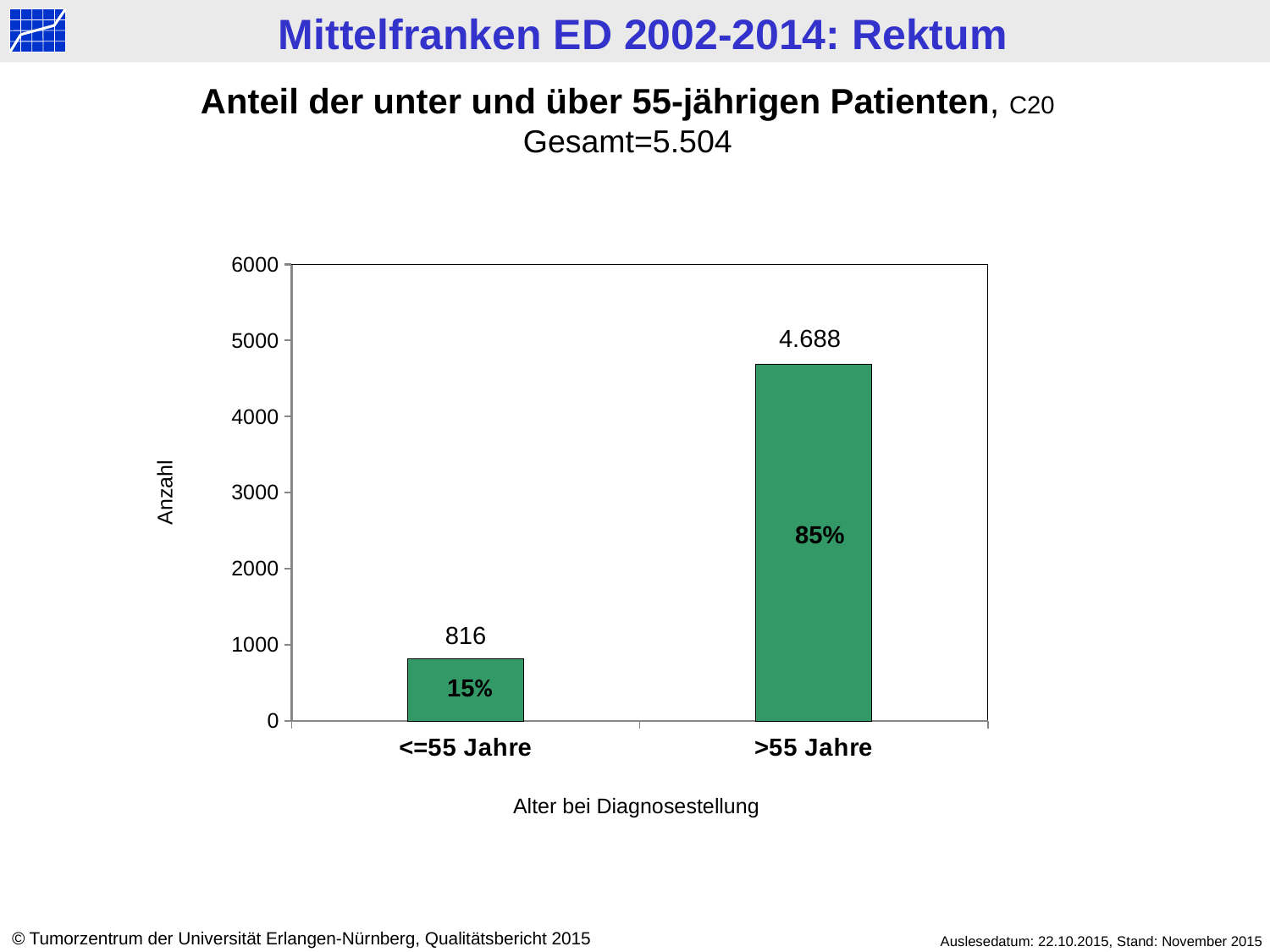
Is the value for ">55 Jahre" greater or less than 4000? greater What is the value for the "<=55 Jahre" category? 816 What is the difference between the values for ">55 Jahre" and "<=55 Jahre"? 3.872 What percentage is shown on the "<=55 Jahre" bar? 15% What percentage is shown on the ">55 Jahre" bar? 85% Which category has the lowest value? <=55 Jahre What is the value for the ">55 Jahre" category? 4.688 What is the label of the x axis? Alter bei Diagnosestellung What kind of chart is shown on the slide? bar chart How many categories are shown on the x axis? 2 Which category has the highest value? >55 Jahre Which is larger, the value for "<=55 Jahre" or the value for ">55 Jahre"? >55 Jahre